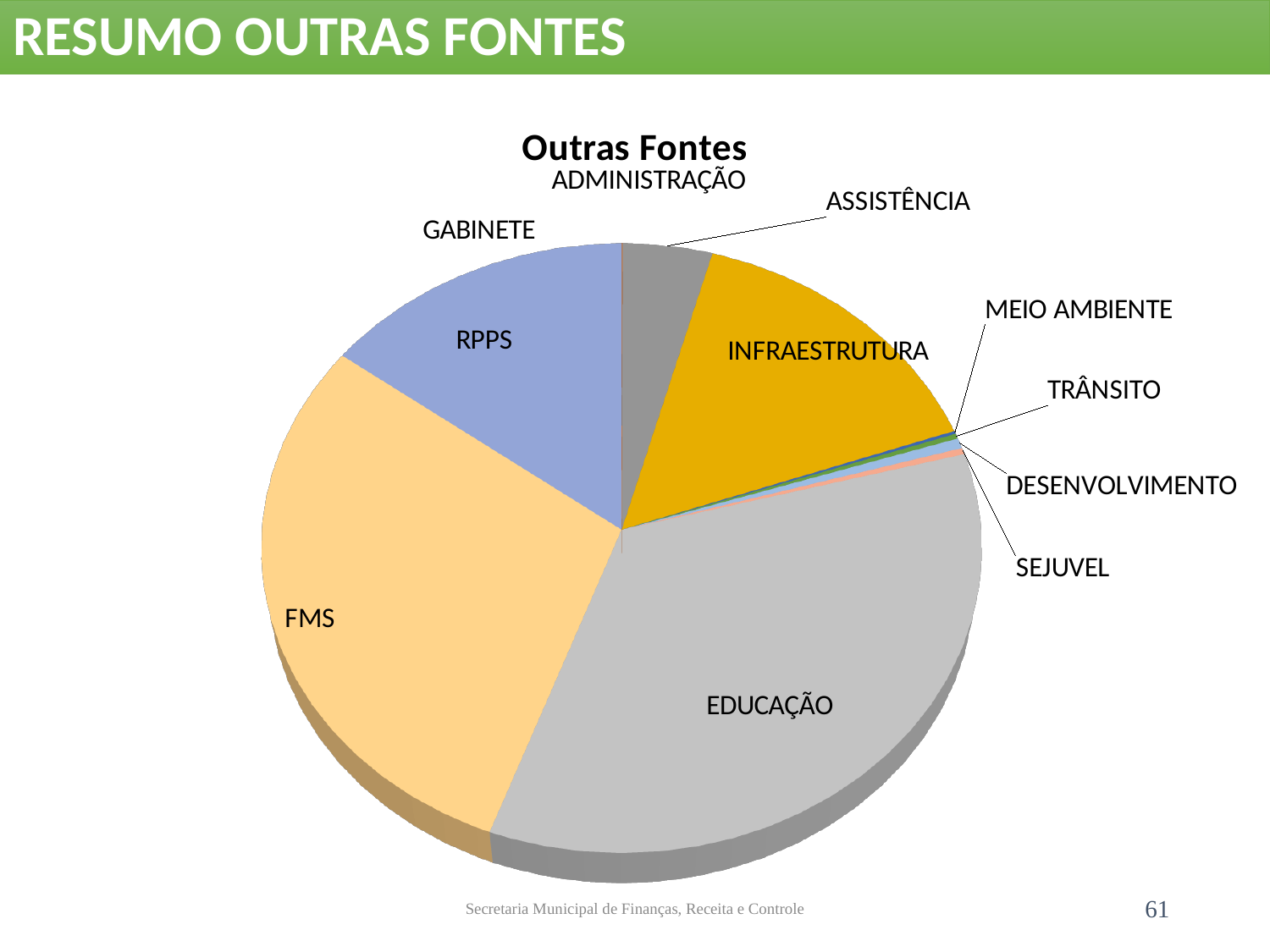
Which slice is larger, RPPS or TRÂNSITO? RPPS Which slice is larger, INFRAESTRUTURA or ADMINISTRAÇÃO? INFRAESTRUTURA What is the title of the chart? Outras Fontes Which slice is larger, EDUCAÇÃO or FMS? EDUCAÇÃO What colour is the EDUCAÇÃO slice? gray What kind of chart is shown on the slide? pie chart Which category has the largest slice of the pie? EDUCAÇÃO How many categories (slices) does the pie chart have? 11